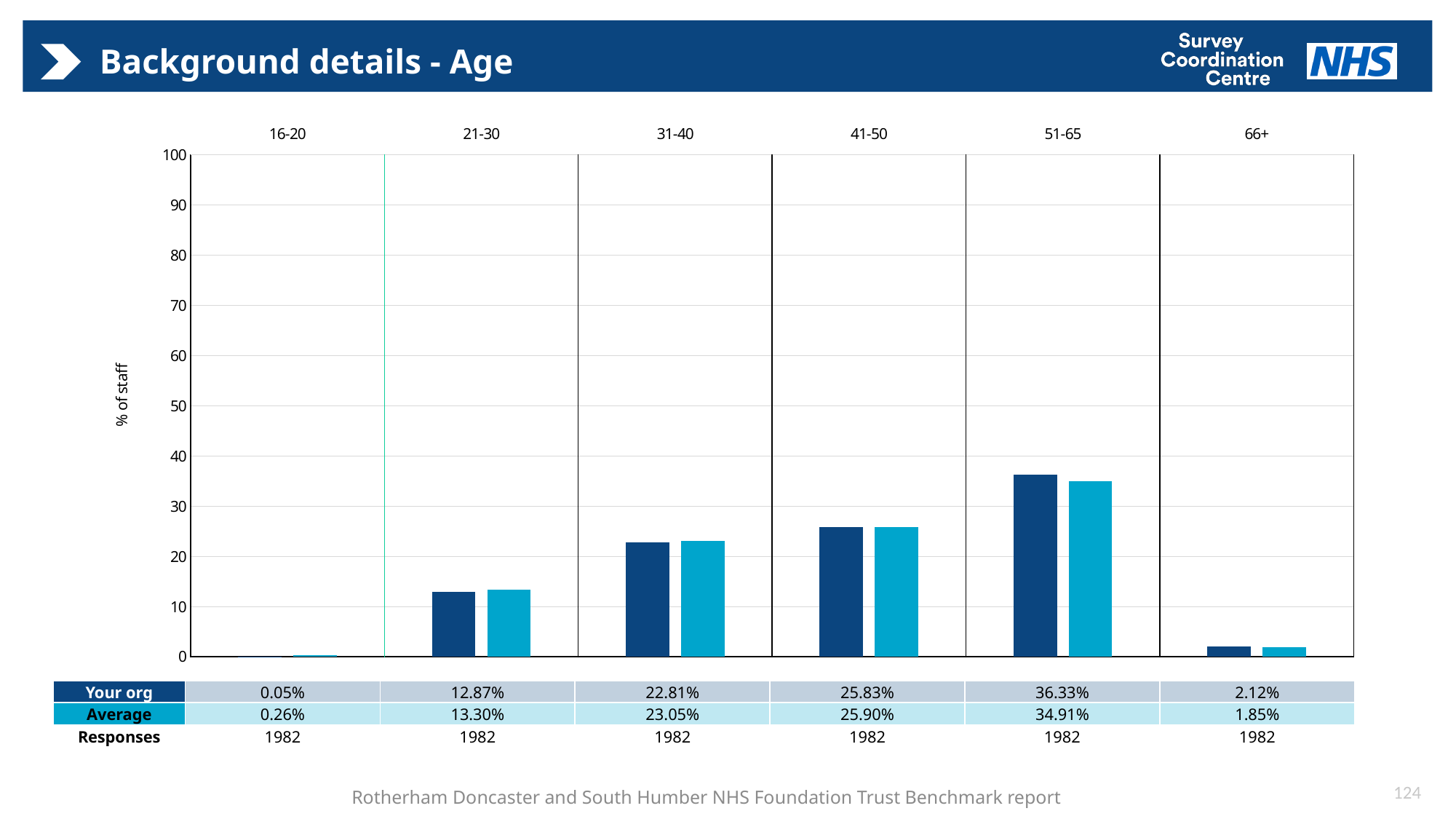
Is the 'Your org' value for the 41-50 age group greater or less than 20? greater What is the 'Your org' value for the 51-65 age group? 36.33% What is the 'Average' value for the 31-40 age group? 23.05% What is the number of responses shown for the 31-40 age group? 1982 How many age groups are shown on the chart? 6 Which age group has the highest 'Your org' value? 51-65 For the 21-30 age group, which is larger: 'Your org' or 'Average'? Average What is the 'Your org' value for the 16-20 age group? 0.05% Which age group has the lowest 'Average' value? 16-20 How many series does the chart show? 2 What kind of chart is shown on the slide? Bar chart What is the difference between the 'Your org' and 'Average' values for the 51-65 age group? 1.42%